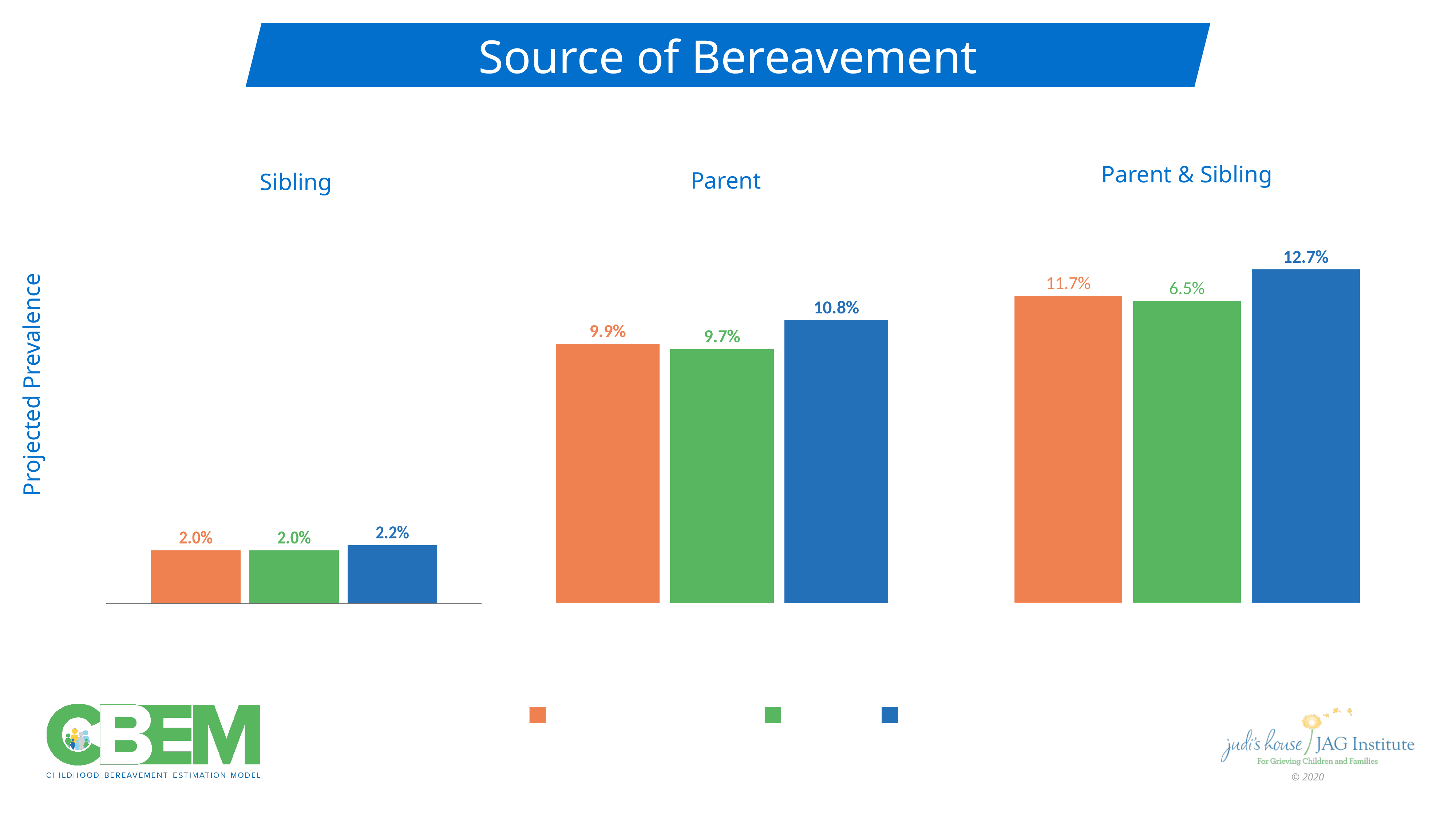
In the Parent chart, which coloured bar is the highest? blue What type of chart is used on this slide? bar chart In the Parent & Sibling chart, what is the value of the green bar? 6.5% How many bars are shown in the Sibling chart? 3 In the Parent & Sibling chart, what is the difference between the blue bar and the green bar? 6.2% In the Parent chart, what is the value of the orange bar? 9.9% In the Parent & Sibling chart, which is larger, the orange bar or the green bar? orange In the Parent chart, what is the difference between the blue bar and the orange bar? 0.9% In the Parent & Sibling chart, which coloured bar is the highest? blue In the Sibling chart, what is the value of the blue bar? 2.2% In the Parent & Sibling chart, which coloured bar is the lowest? green In the Parent chart, what is the value of the green bar? 9.7%